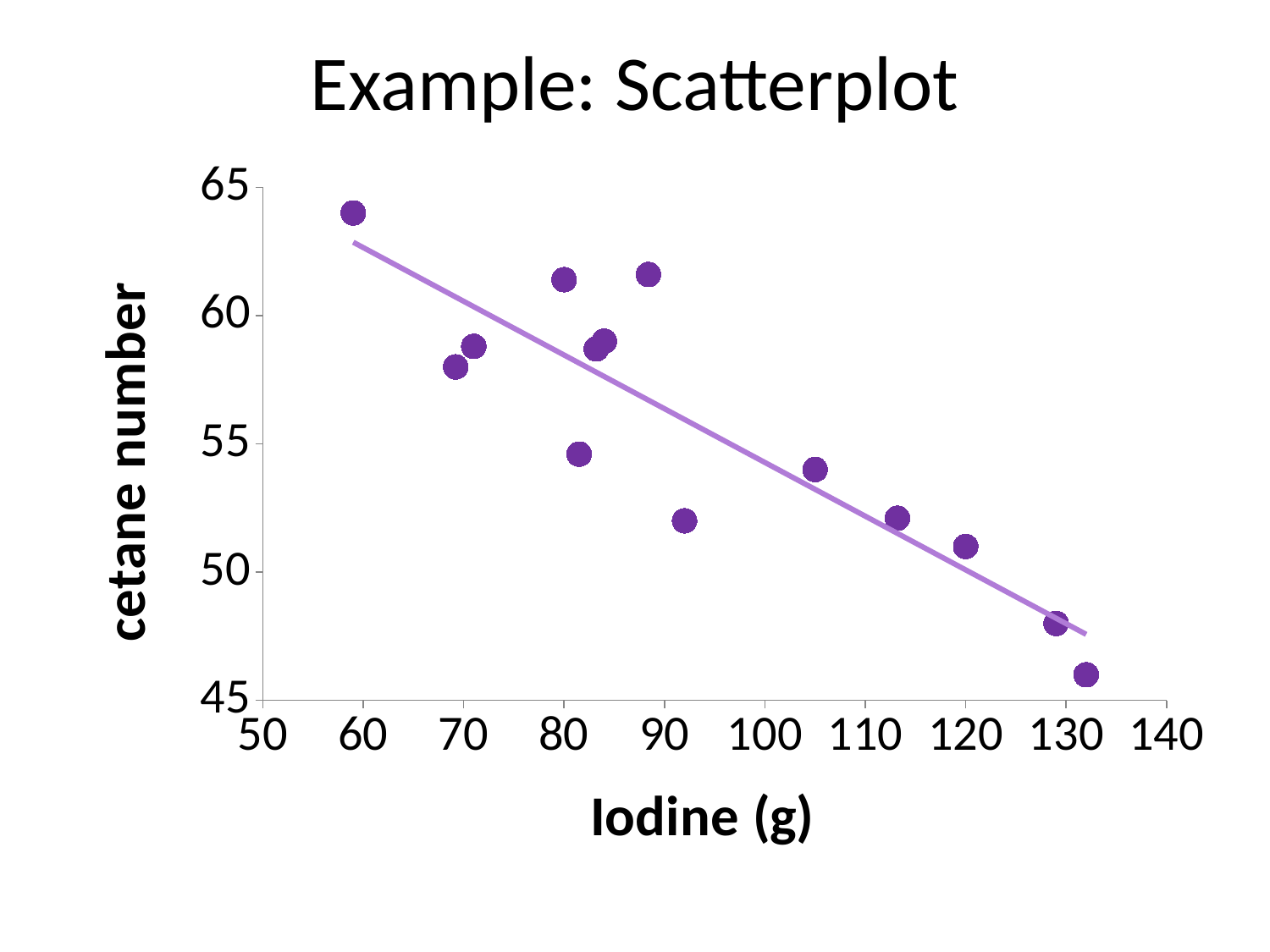
As iodine (g) increases along the x axis, does the cetane number generally rise or fall? fall What is the label of the y axis? cetane number Which has the larger cetane number: the point at about 70 g iodine or the point at about 120 g iodine? the point at about 70 g iodine Is the cetane number of the point at about 92 g iodine greater or less than 55? less Is the cetane number of the leftmost point (at about 60 g iodine) greater or less than 60? greater Is the cetane number of the point at about 113 g iodine greater or less than 55? less Which point has the highest cetane number: the leftmost point or the rightmost point? the leftmost point What is the label of the x axis? Iodine (g) What kind of chart is shown on the slide? scatter plot What is the highest value shown on the y axis? 65